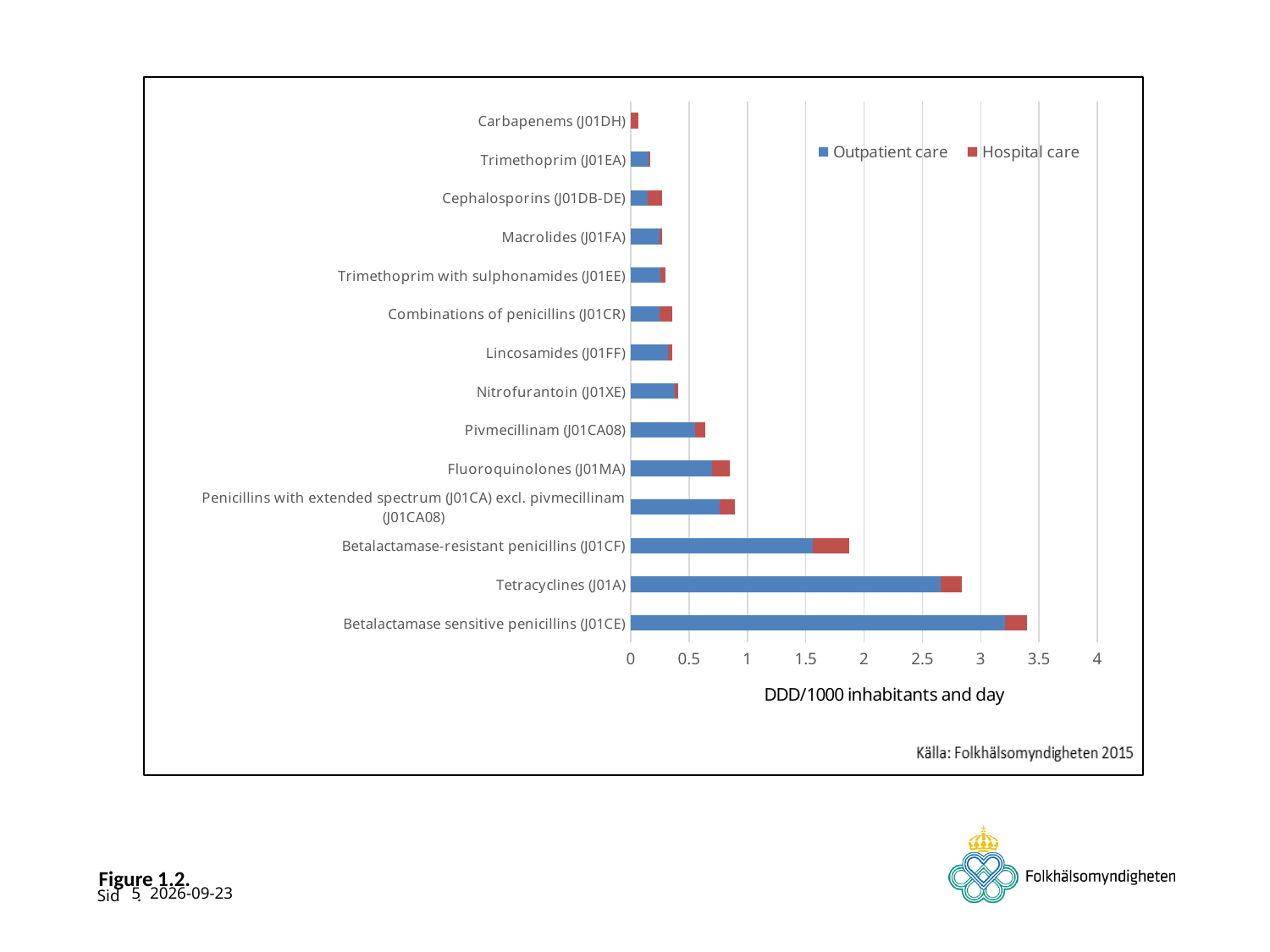
Which category has the highest total value? Betalactamase sensitive penicillins (J01CE) How many series does the legend list? 2 Which colour represents Hospital care in the chart? Red Which category has the lowest total value? Carbapenems (J01DH) Is the total value for Tetracyclines (J01A) greater or less than 2.5? greater Is the total value for Fluoroquinolones (J01MA) greater or less than 1? less What kind of chart is shown on the slide? Bar chart Is the total value for Betalactamase-resistant penicillins (J01CF) greater or less than 1.5? greater What is the title of the horizontal axis? DDD/1000 inhabitants and day How many antibiotic categories are plotted on the chart? 14 Which has the larger total value, Tetracyclines (J01A) or Betalactamase-resistant penicillins (J01CF)? Tetracyclines (J01A)